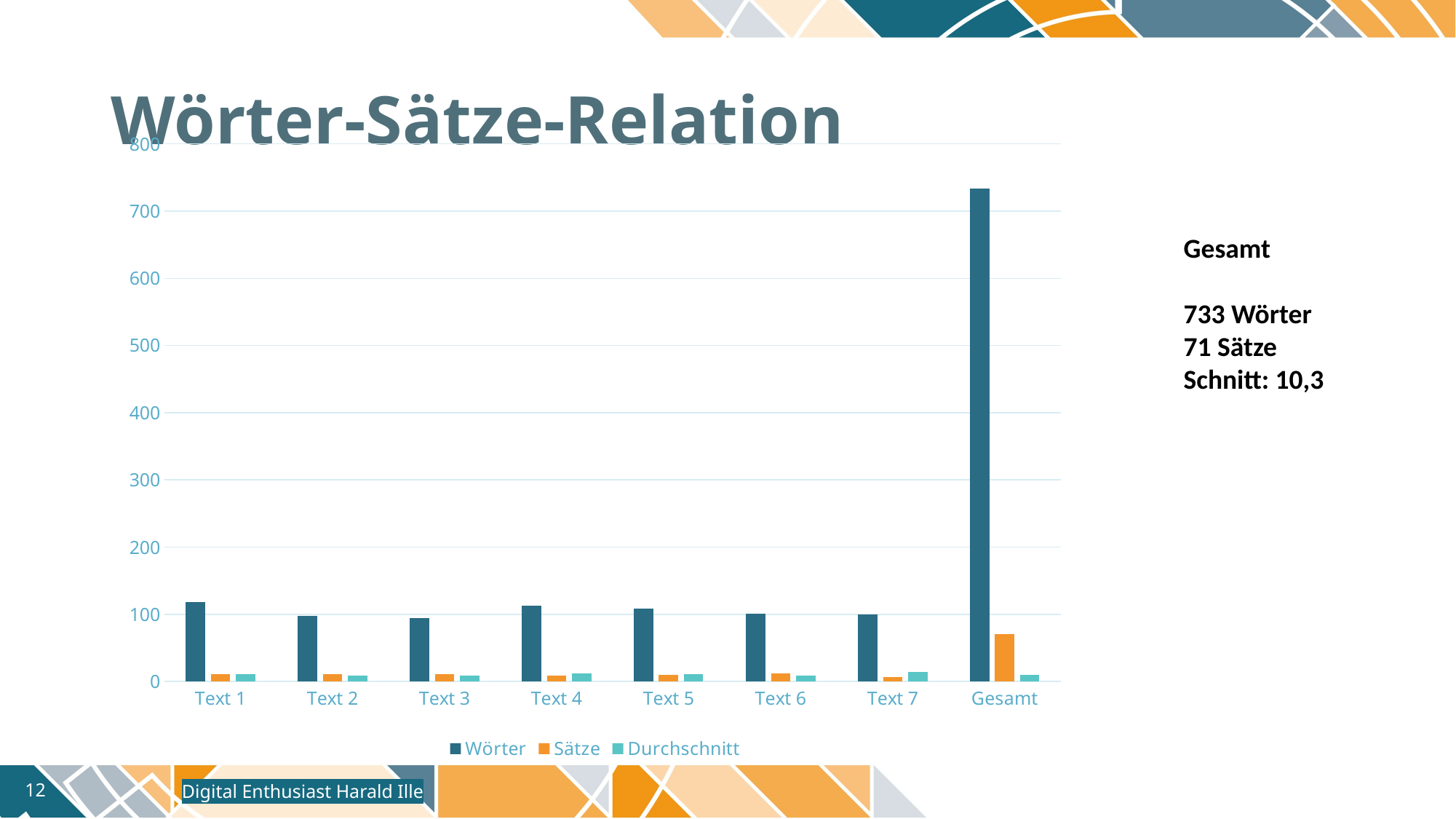
What is the title of the chart slide? Wörter-Sätze-Relation What kind of chart is shown on the slide? bar chart How many series does the chart legend list? 3 Is the Wörter value for Text 4 greater or less than 100? greater How many categories are shown on the x axis of the chart? 8 Which category has the highest Wörter value? Gesamt Among Text 1 to Text 7, which category has the highest Wörter value? Text 1 Is the Wörter value for Gesamt greater or less than 700? greater Which is larger, the Sätze value for Gesamt or for Text 1? Gesamt Which is larger, the Wörter value for Text 1 or for Text 3? Text 1 Is the Wörter value for Text 1 greater or less than 100? greater